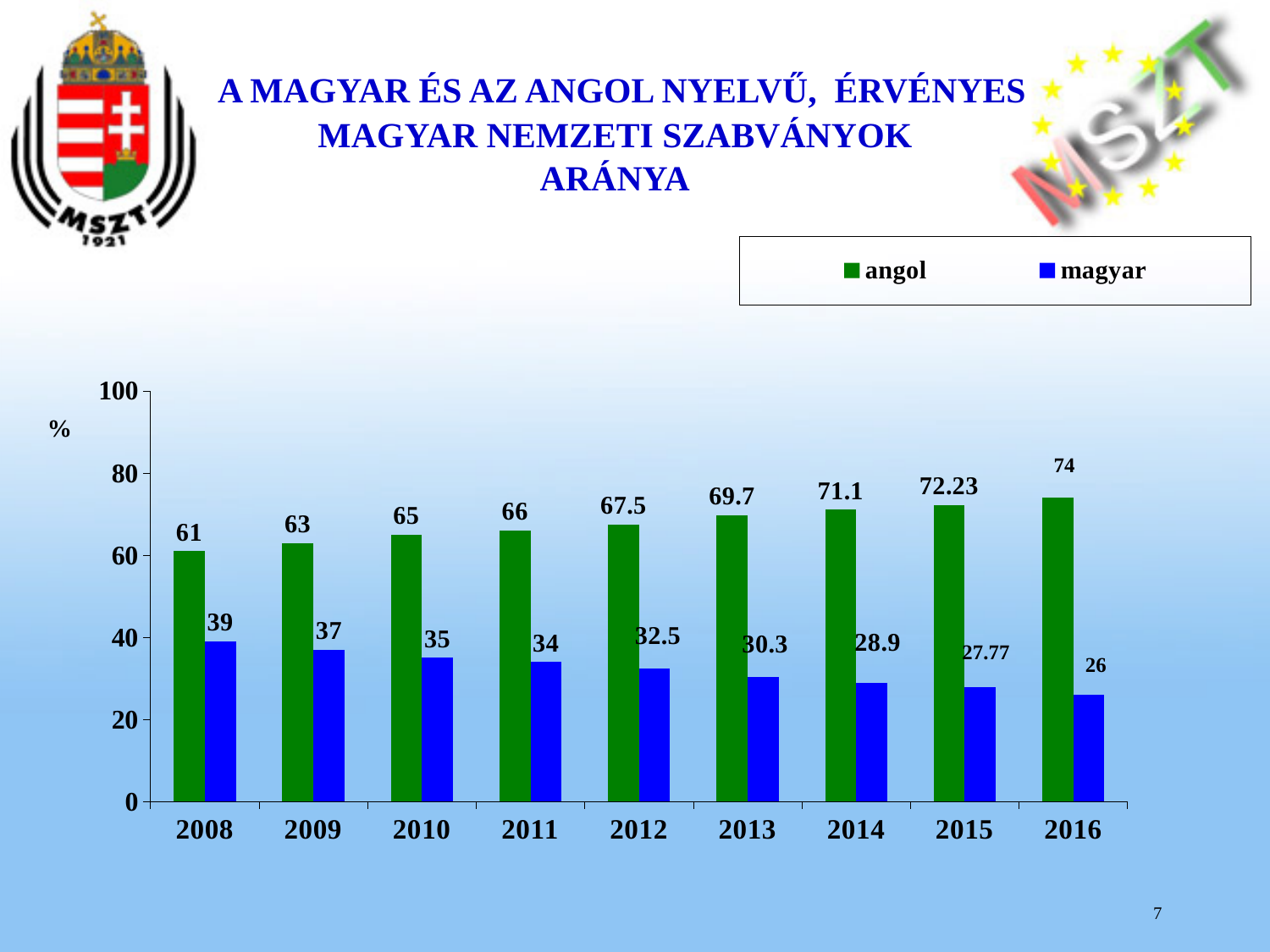
What is the value for angol in 2012? 67.5 In which year is the magyar value lowest? 2016 Which is larger, the magyar value in 2009 or the magyar value in 2013? 2009 How many years are shown on the x axis? 9 Do the magyar values rise or fall from 2008 to 2016? fall What kind of chart is shown on the slide? bar chart In which year is the angol value highest? 2016 What is the value for magyar in 2015? 27.77 How many series does the legend list? 2 What colour are the bars for the angol series? green What is the difference between the angol and magyar values in 2008? 22 Is the angol value for 2014 greater or less than 60? greater